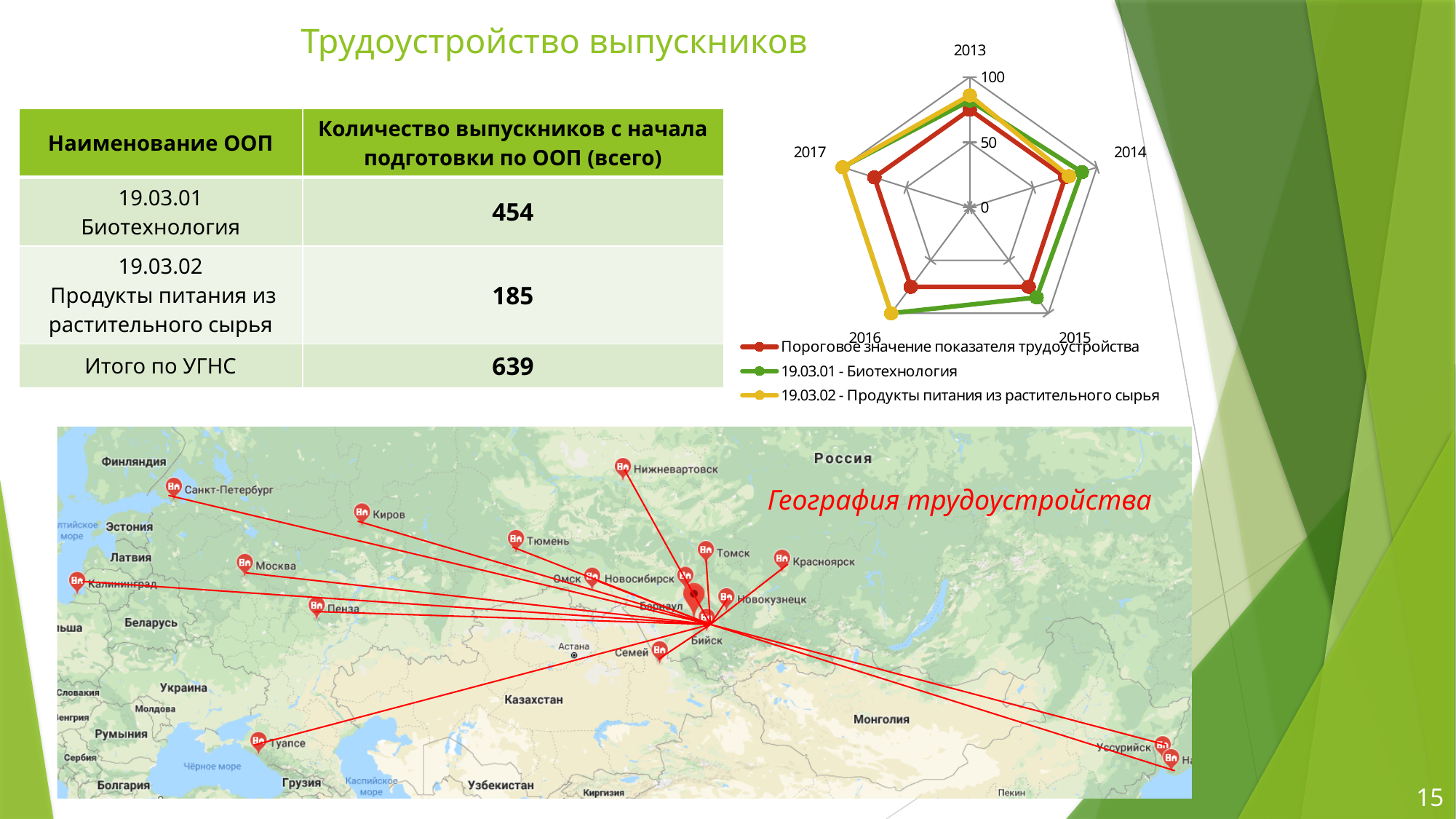
In the radar chart, is the value of 'Пороговое значение показателя трудоустройства' for 2013 greater or less than 50? greater How many years (axes) does the radar chart have? 5 What is the maximum value shown on the radar chart's scale? 100 What kind of chart is shown in the top right of the slide? radar chart Which years are shown on the axes of the radar chart? 2013, 2014, 2015, 2016, 2017 How many series does the legend of the radar chart list? 3 In the radar chart, is the value of '19.03.02 - Продукты питания из растительного сырья' for 2017 greater or less than 50? greater In the radar chart, which is larger for 2014: '19.03.01 - Биотехнология' or 'Пороговое значение показателя трудоустройства'? 19.03.01 - Биотехнология In the radar chart, which series has the lowest value for 2013? Пороговое значение показателя трудоустройства In the radar chart, is the value of '19.03.01 - Биотехнология' for 2014 greater or less than 50? greater In the radar chart, which is larger for 2017: '19.03.02 - Продукты питания из растительного сырья' or 'Пороговое значение показателя трудоустройства'? 19.03.02 - Продукты питания из растительного сырья In the radar chart, which is larger for 2016: '19.03.02 - Продукты питания из растительного сырья' or 'Пороговое значение показателя трудоустройства'? 19.03.02 - Продукты питания из растительного сырья